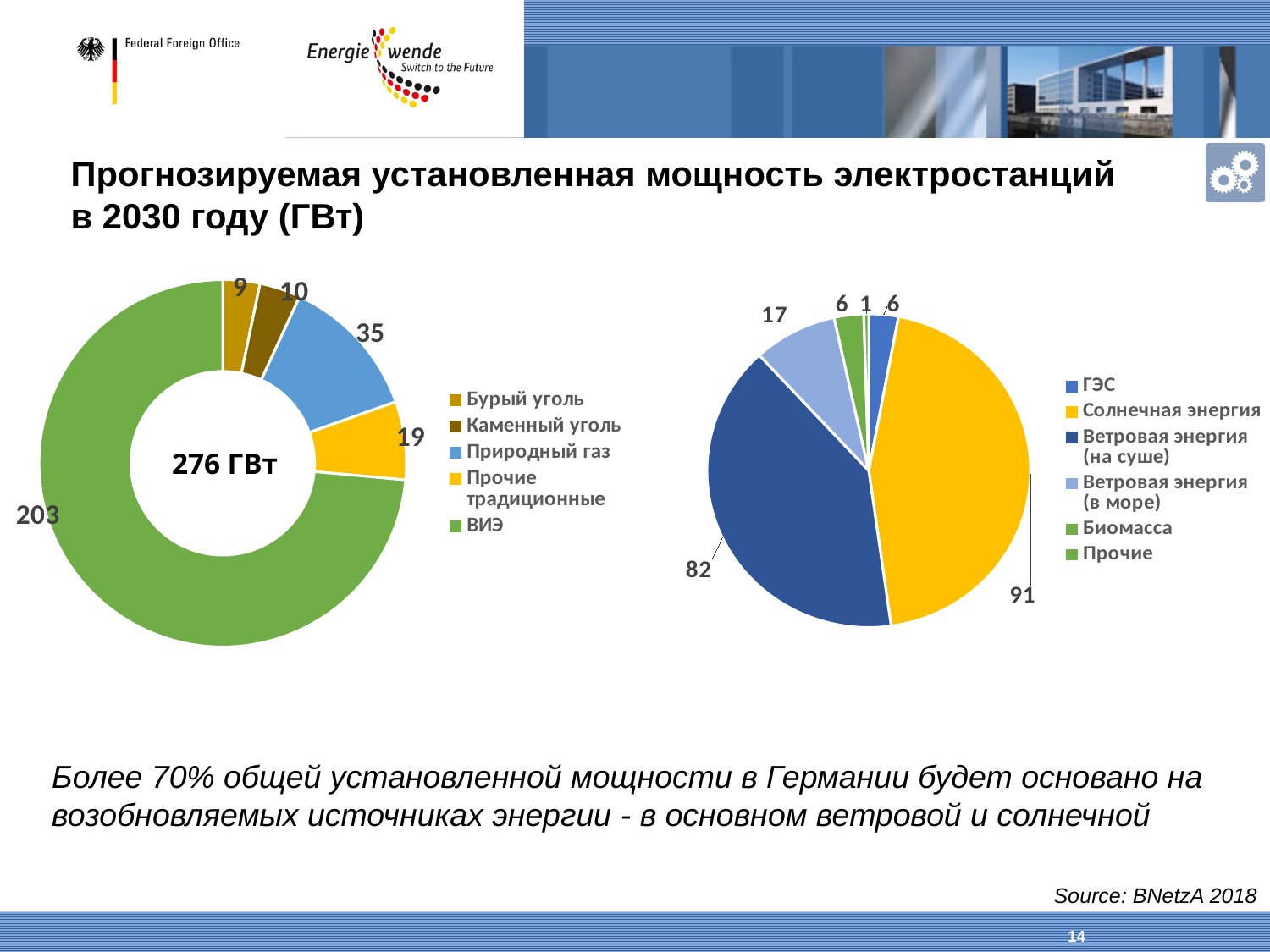
On the left donut chart, what total is shown in the centre? 276 ГВт On the right pie chart, which is larger: Солнечная энергия or Ветровая энергия (на суше)? Солнечная энергия On the left donut chart, which category has the smallest value? Бурый уголь On the left donut chart, what is the difference between Природный газ and Прочие традиционные? 16 On the right pie chart, which category has the largest value? Солнечная энергия On the left donut chart, what is the value for Природный газ? 35 On the right pie chart, what is the value for Солнечная энергия? 91 On the right pie chart, what is the value for Ветровая энергия (в море)? 17 On the left donut chart, what is the value for ВИЭ? 203 On the right pie chart, how many categories does the legend list? 6 What type of chart is the chart on the right? Pie chart On the left donut chart, how many categories does the legend list? 5